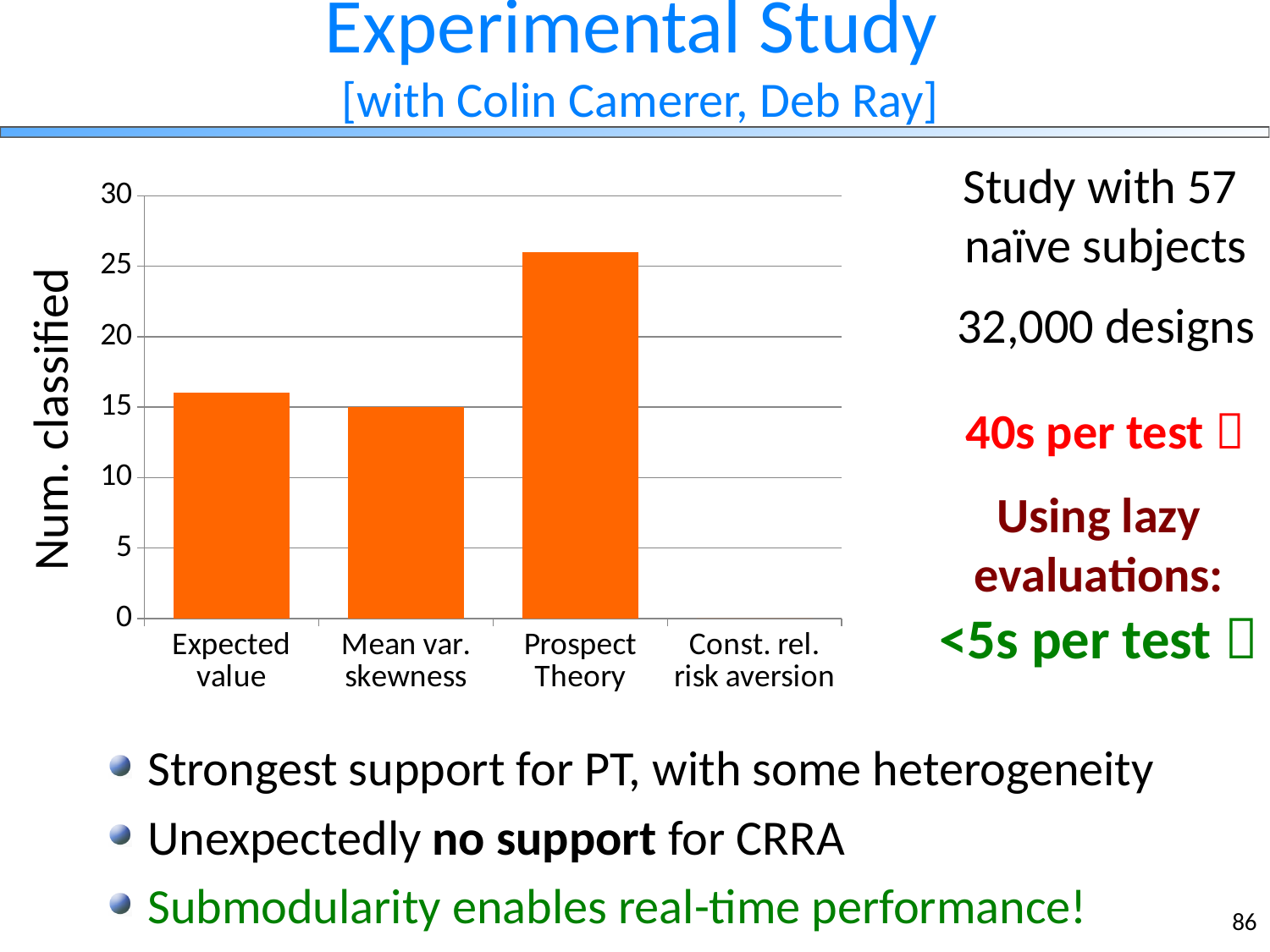
What is the label on the vertical axis of the chart? Num. classified Which has a larger number classified, Prospect Theory or Expected value? Prospect Theory How many categories are shown on the x axis of the chart? 4 Is the value for Prospect Theory greater or less than 30? less Which has a larger number classified, Mean var. skewness or Const. rel. risk aversion? Mean var. skewness Is the value for Prospect Theory greater or less than 20? greater Is the value for Expected value greater or less than 20? less What kind of chart is shown on the slide? bar chart What is the number classified for Mean var. skewness? 15 What is the number classified for Const. rel. risk aversion? 0 Which category has the highest number classified? Prospect Theory Which category has the lowest number classified? Const. rel. risk aversion